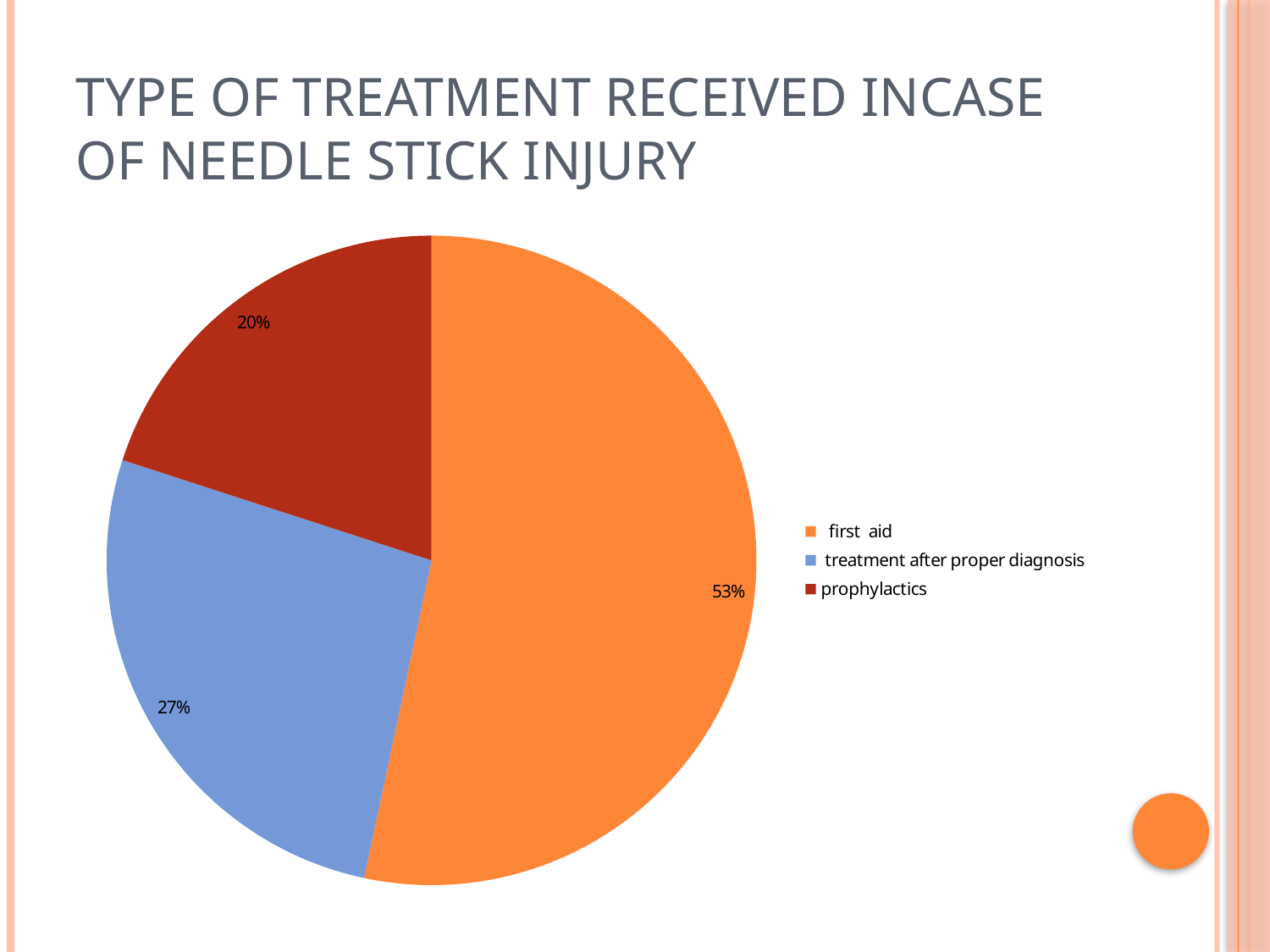
What share of the pie does prophylactics represent? 20% Which category has the largest slice of the pie? first aid What is the title of the slide? TYPE OF TREATMENT RECEIVED INCASE OF NEEDLE STICK INJURY What colour is the slice for treatment after proper diagnosis? blue Which is larger, the share for treatment after proper diagnosis or the share for prophylactics? treatment after proper diagnosis Which category has the smallest slice of the pie? prophylactics What kind of chart is shown on the slide? pie chart What is the difference in percentage points between treatment after proper diagnosis and prophylactics? 7 How many categories does the pie chart have? 3 What share of the pie does first aid represent? 53% What share of the pie does treatment after proper diagnosis represent? 27% What is the difference in percentage points between first aid and prophylactics? 33